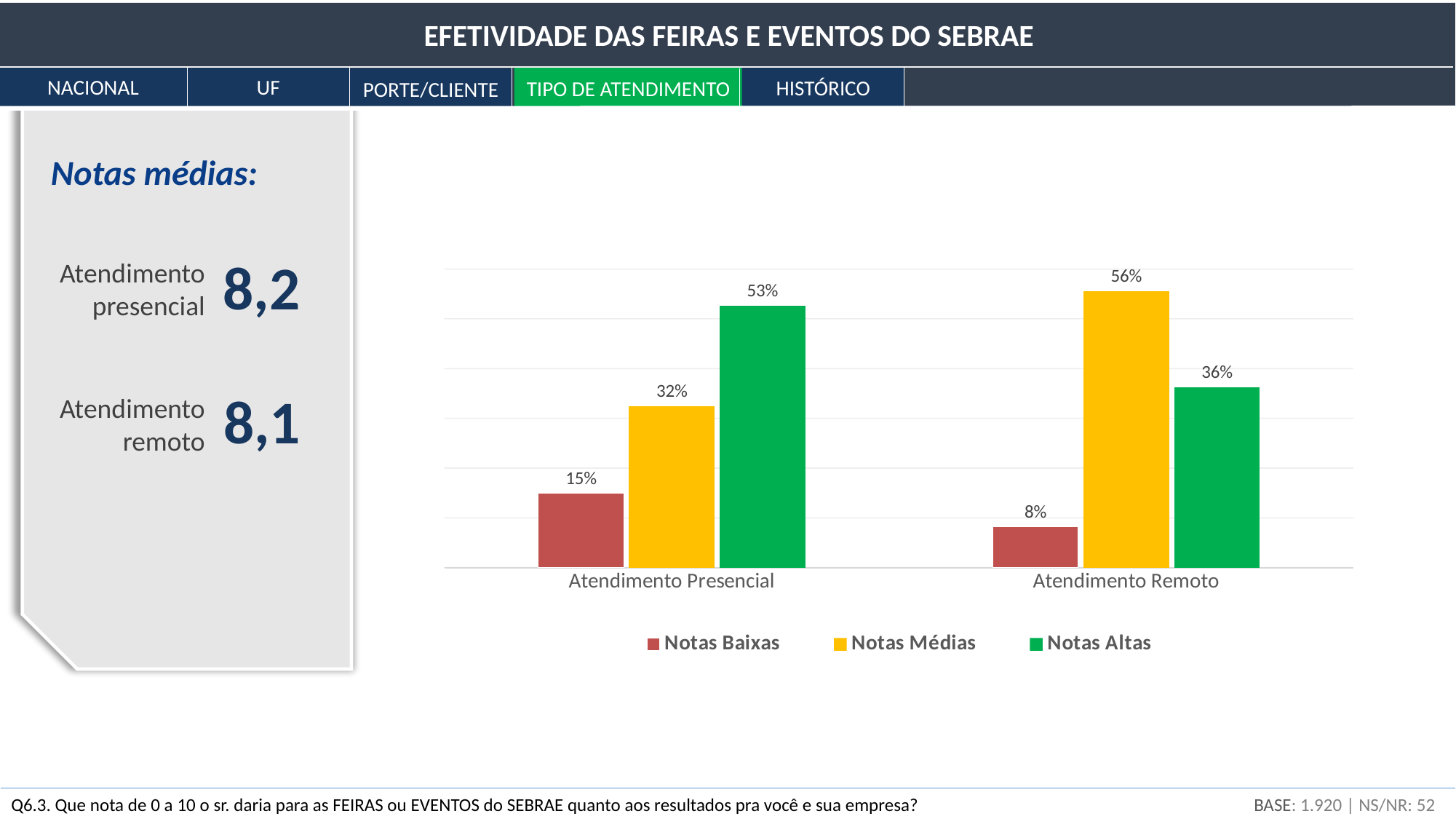
What is the value for Notas Baixas in the Atendimento Remoto category? 8% What is the value for Notas Baixas in the Atendimento Presencial category? 15% How many categories are shown on the x axis of the chart? 2 What is the difference between Notas Altas for Atendimento Presencial and Notas Altas for Atendimento Remoto? 17% What is the value for Notas Médias in the Atendimento Remoto category? 56% What is the value for Notas Altas in the Atendimento Presencial category? 53% What colour represents the Notas Médias series in the chart? Yellow What kind of chart is shown on the slide? Bar chart How many series does the chart legend list? 3 Which is larger: Notas Médias for Atendimento Presencial or Notas Médias for Atendimento Remoto? Atendimento Remoto Which series has the highest value in the Atendimento Presencial category? Notas Altas Which series has the lowest value in the Atendimento Remoto category? Notas Baixas